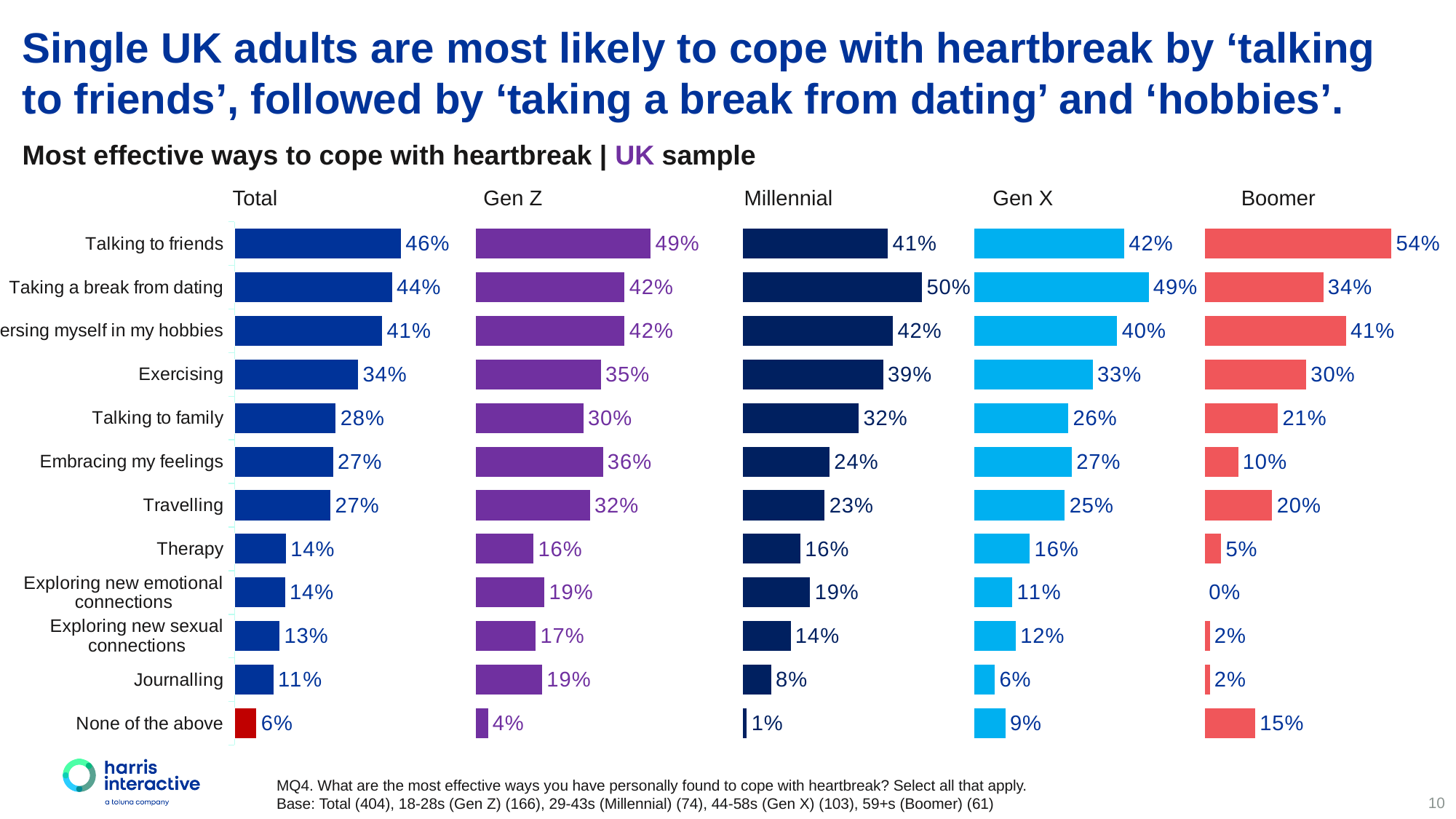
What type of chart is used for the Gen X data? Bar chart In the Total chart, what percentage is shown for 'Talking to friends'? 46% In the Gen X chart, what is the difference between 'Taking a break from dating' and 'Exercising'? 16% How many categories are listed in the Total chart? 12 In the Boomer chart, what percentage is shown for 'Embracing my feelings'? 10% In the Boomer chart, which is larger: 'Talking to friends' or 'Taking a break from dating'? Talking to friends In the Millennial chart, which category has the highest value? Taking a break from dating How many separate bar charts (groups) are shown on the slide? 5 In the Gen Z chart, what is the difference between 'Talking to friends' and 'Journalling'? 30% In the Millennial chart, what percentage is shown for 'None of the above'? 1% In the Gen X chart, which category has the lowest value? Journalling In the Boomer chart, what percentage is shown for 'Exploring new emotional connections'? 0%